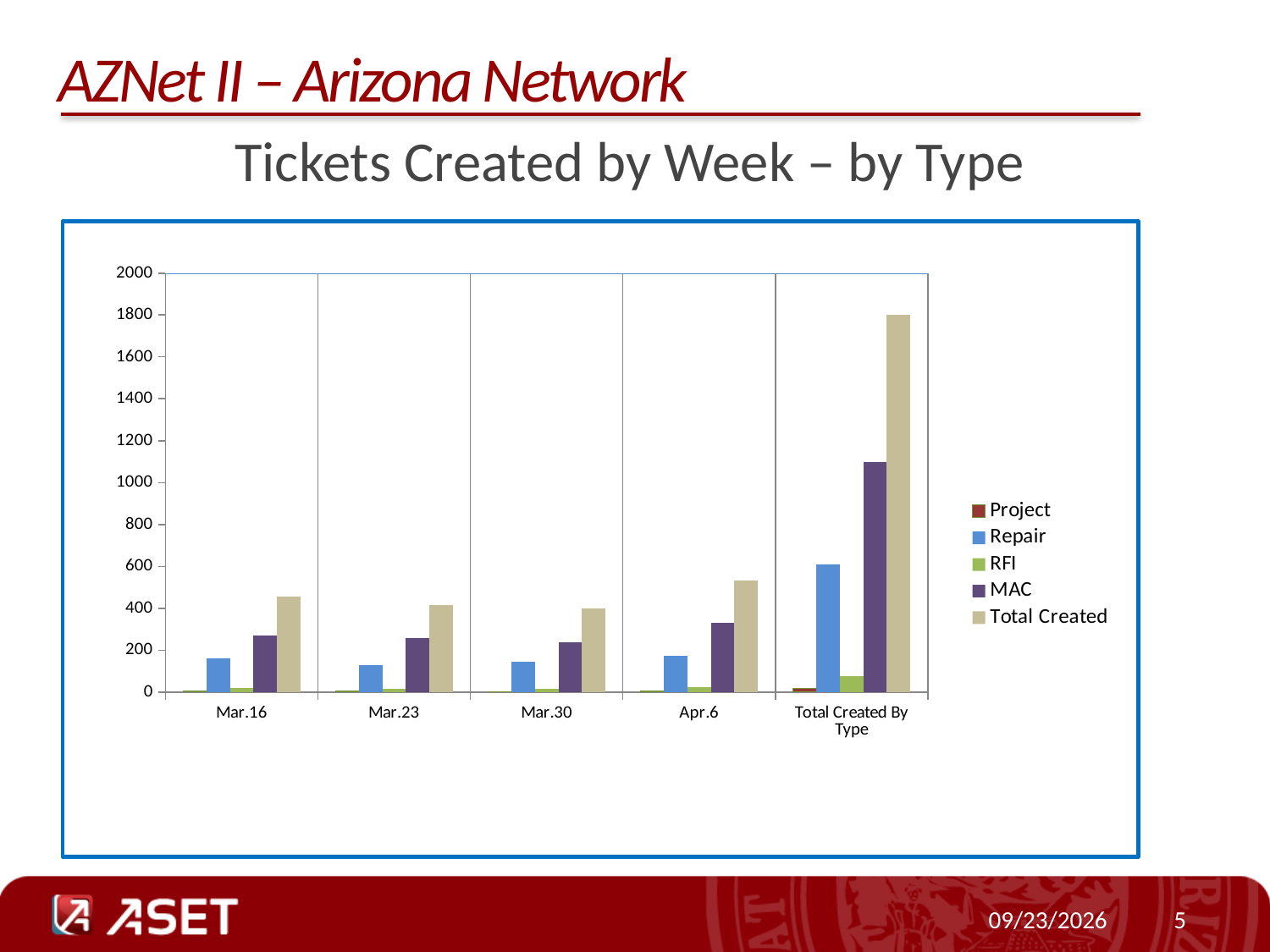
How many series does the legend list? 5 In the Total Created By Type category, which series has the lowest value? Project For Mar.16, which is larger, the MAC value or the Repair value? MAC Is the Total Created value for Mar.16 greater or less than 400? greater Is the Repair value for the Total Created By Type category greater or less than 800? less Is the Total Created value for the Total Created By Type category greater or less than 1600? greater How many categories are shown along the x axis? 5 Among the weeks Mar.16, Mar.23, Mar.30 and Apr.6, which has the highest Total Created value? Apr.6 What kind of chart is shown on the slide? bar chart What is the title of the chart? Tickets Created by Week – by Type